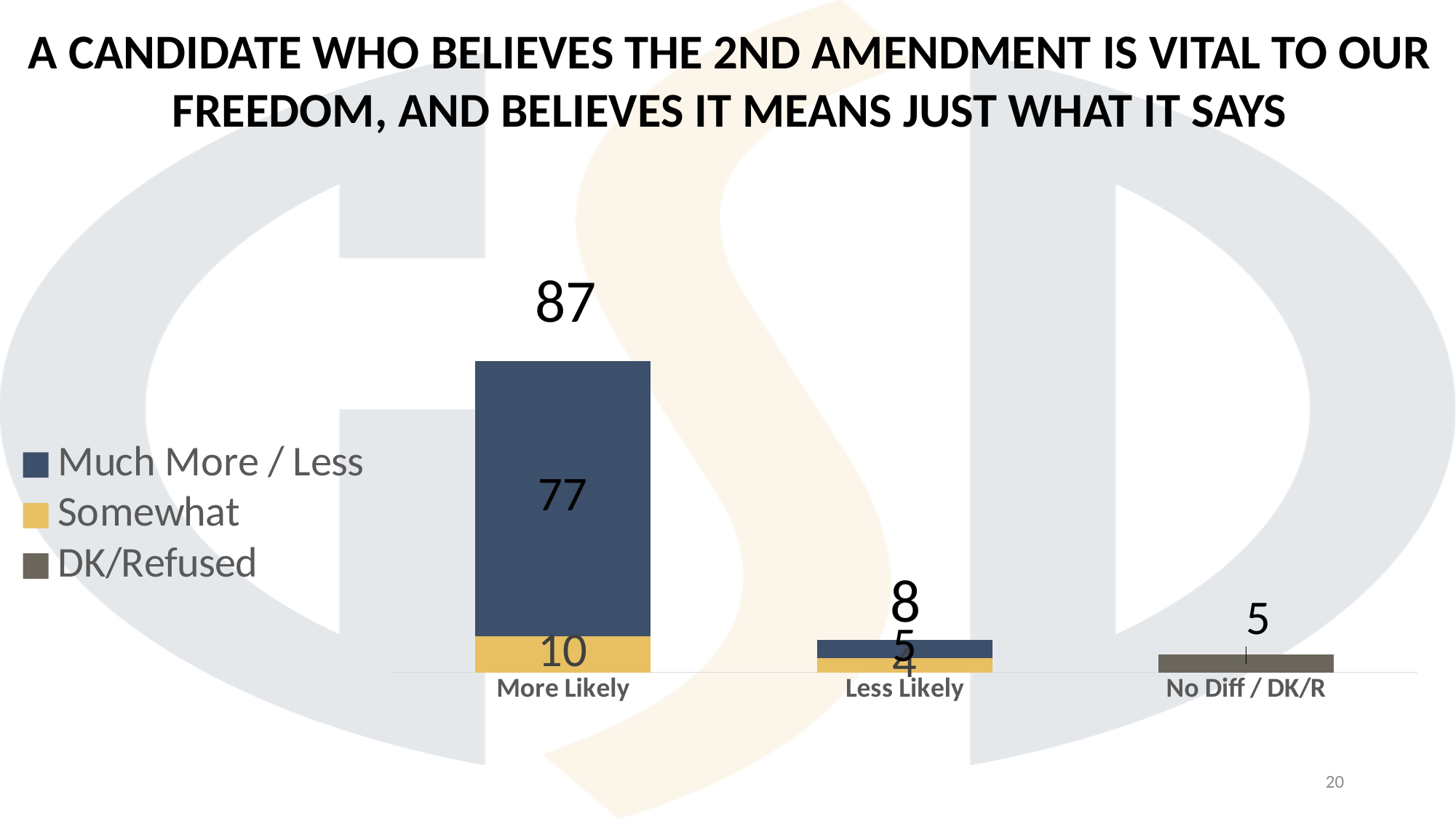
What is the Somewhat value for Less Likely? 4 What is the value for No Diff / DK/R? 5 What is the total shown above the More Likely bar? 87 What is the Somewhat value for More Likely? 10 How many categories are shown on the x axis? 3 What is the difference between the More Likely total and the Less Likely total? 79 What is the Much More / Less value for More Likely? 77 What is the total shown above the Less Likely bar? 8 Which category has the highest total? More Likely What type of chart is shown on the slide? stacked bar chart How many series does the legend list? 3 What is the Much More / Less value for Less Likely? 5